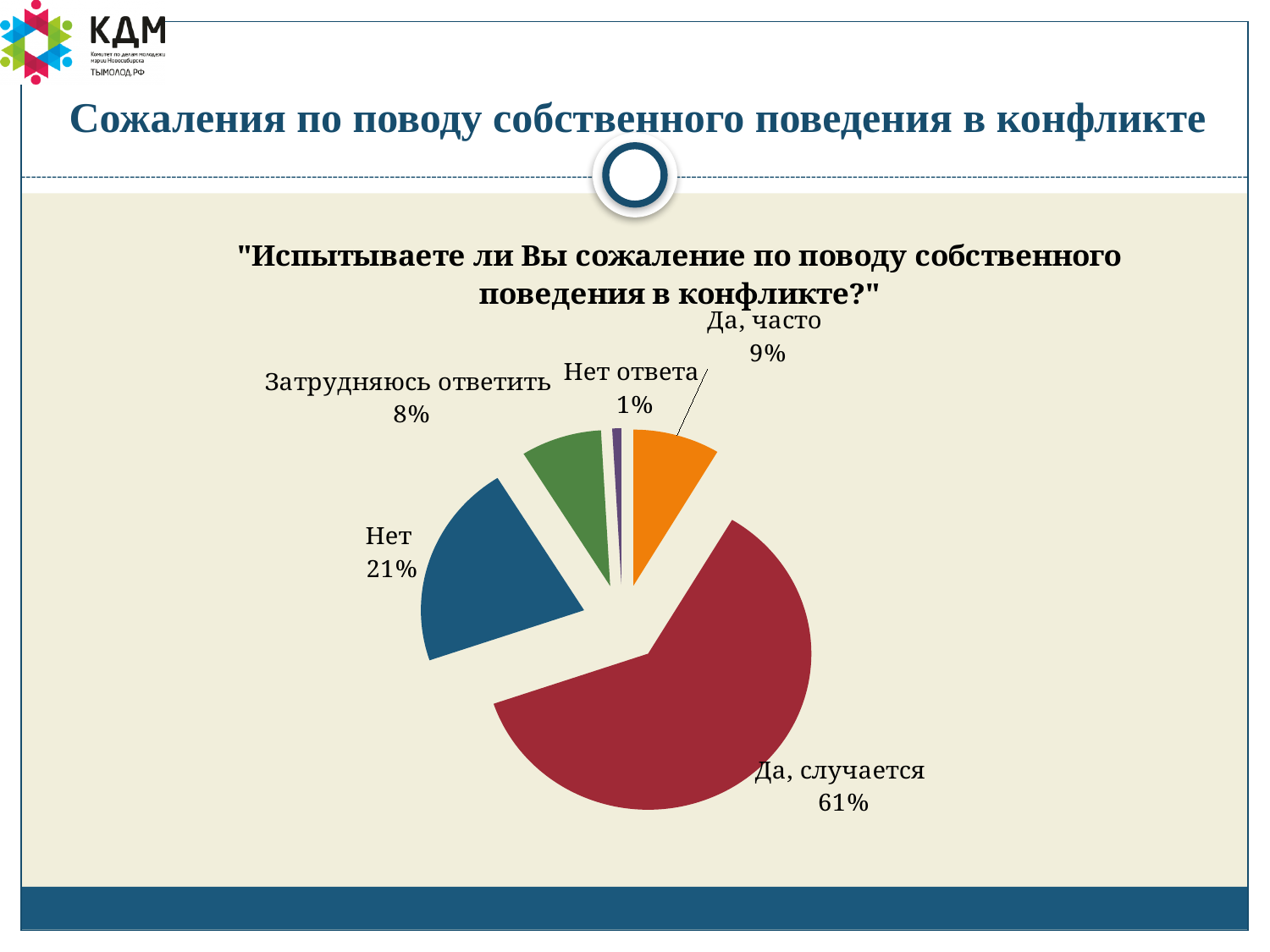
What percentage of respondents answered "Затрудняюсь ответить"? 8% What kind of chart is shown on the slide? pie chart How many slices does the pie chart have? 5 What percentage of respondents answered "Да, часто"? 9% Which is larger, the share for "Да, часто" or the share for "Затрудняюсь ответить"? Да, часто Which answer has the smallest share of the pie? Нет ответа What percentage of respondents gave "Нет ответа"? 1% What percentage of respondents answered "Нет"? 21% What percentage of respondents answered "Да, случается"? 61% Which answer has the largest share of the pie? Да, случается What is the difference in percentage points between "Да, случается" and "Нет"? 40 What colour is the slice for "Нет"? blue